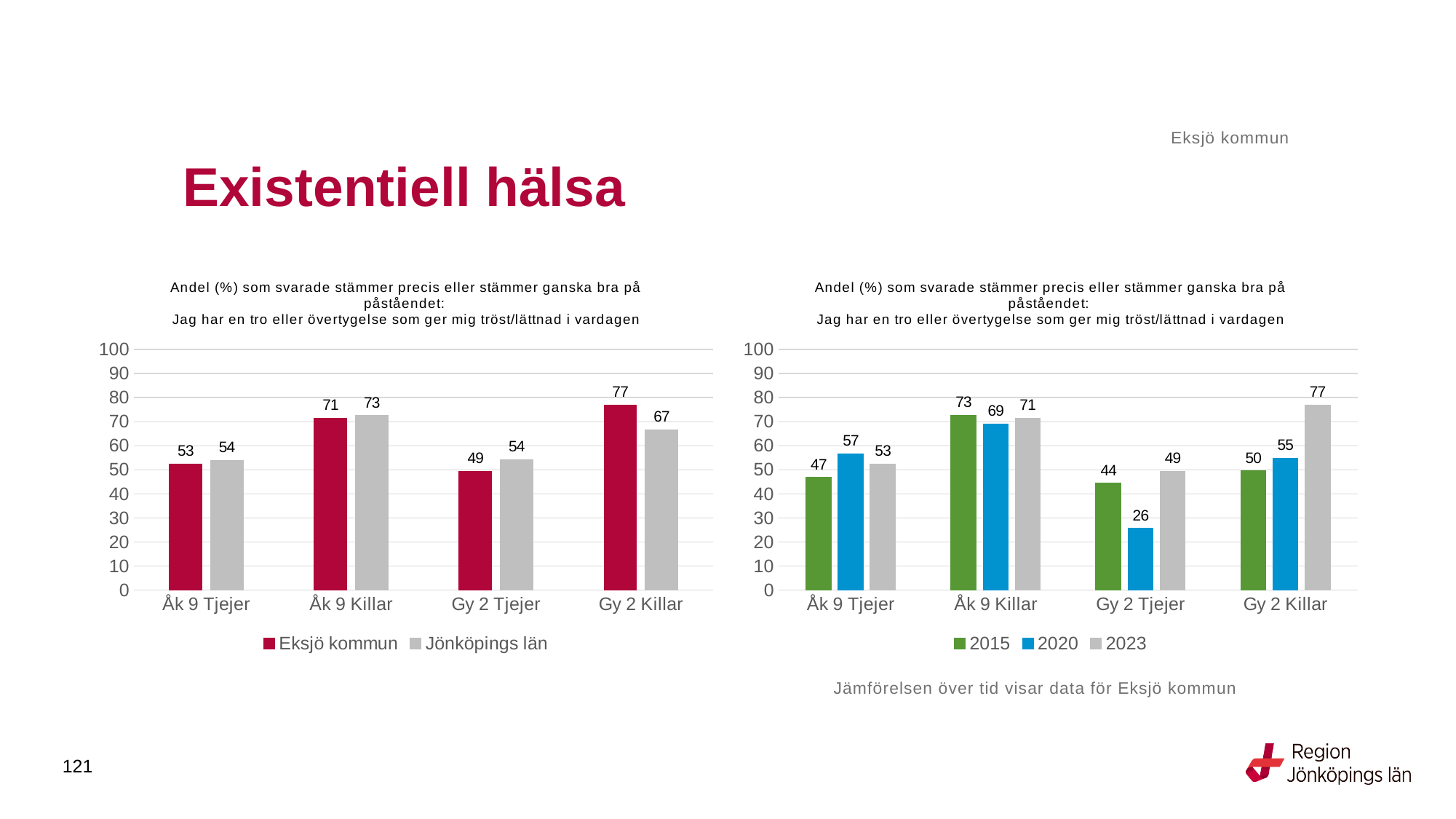
How many categories are shown on the x axis of the left chart? 4 In the left chart, what is the value for Eksjö kommun for Gy 2 Killar? 77 In the right chart, which is larger for Åk 9 Tjejer: the 2015 value or the 2020 value? 2020 In the left chart, what is the value for Jönköpings län for Åk 9 Killar? 73 In the right chart, which category has the highest value for 2023? Gy 2 Killar In the right chart, what is the value for 2015 for Åk 9 Tjejer? 47 What type of chart is the left chart? Bar chart In the left chart, what is the difference between Eksjö kommun and Jönköpings län for Gy 2 Killar? 10 How many series does the legend of the right chart list? 3 In the right chart, what is the value for 2020 for Gy 2 Tjejer? 26 In the left chart, which category has the lowest value for Eksjö kommun? Gy 2 Tjejer In the right chart, what is the difference between the 2023 and 2020 values for Gy 2 Tjejer? 23